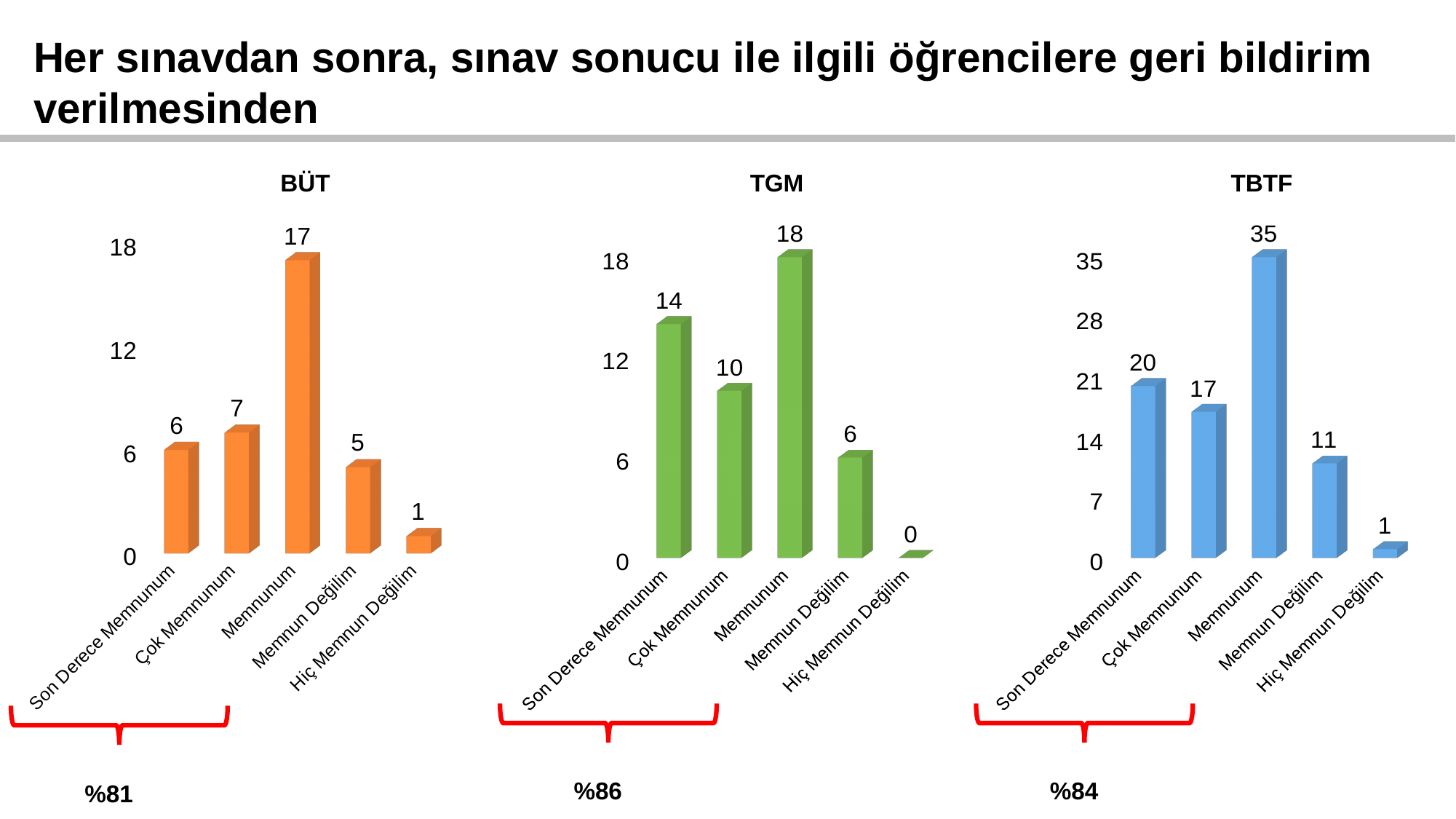
How many categories are shown in the BÜT chart? 5 In the TBTF chart, what is the value for Memnun Değilim? 11 In the BÜT chart, what is the difference between the values for Memnunum and Çok Memnunum? 10 What colour are the bars in the TBTF chart? blue In the TBTF chart, what is the value for Hiç Memnun Değilim? 1 In the TGM chart, which is larger: the value for Çok Memnunum or the value for Memnun Değilim? Çok Memnunum In the BÜT chart, what is the value for Memnunum? 17 In the TBTF chart, what is the difference between the values for Son Derece Memnunum and Çok Memnunum? 3 In the TGM chart, what is the value for Son Derece Memnunum? 14 In the TBTF chart, which category has the highest value? Memnunum What kind of chart is the TGM chart? bar chart In the TGM chart, which category has the lowest value? Hiç Memnun Değilim